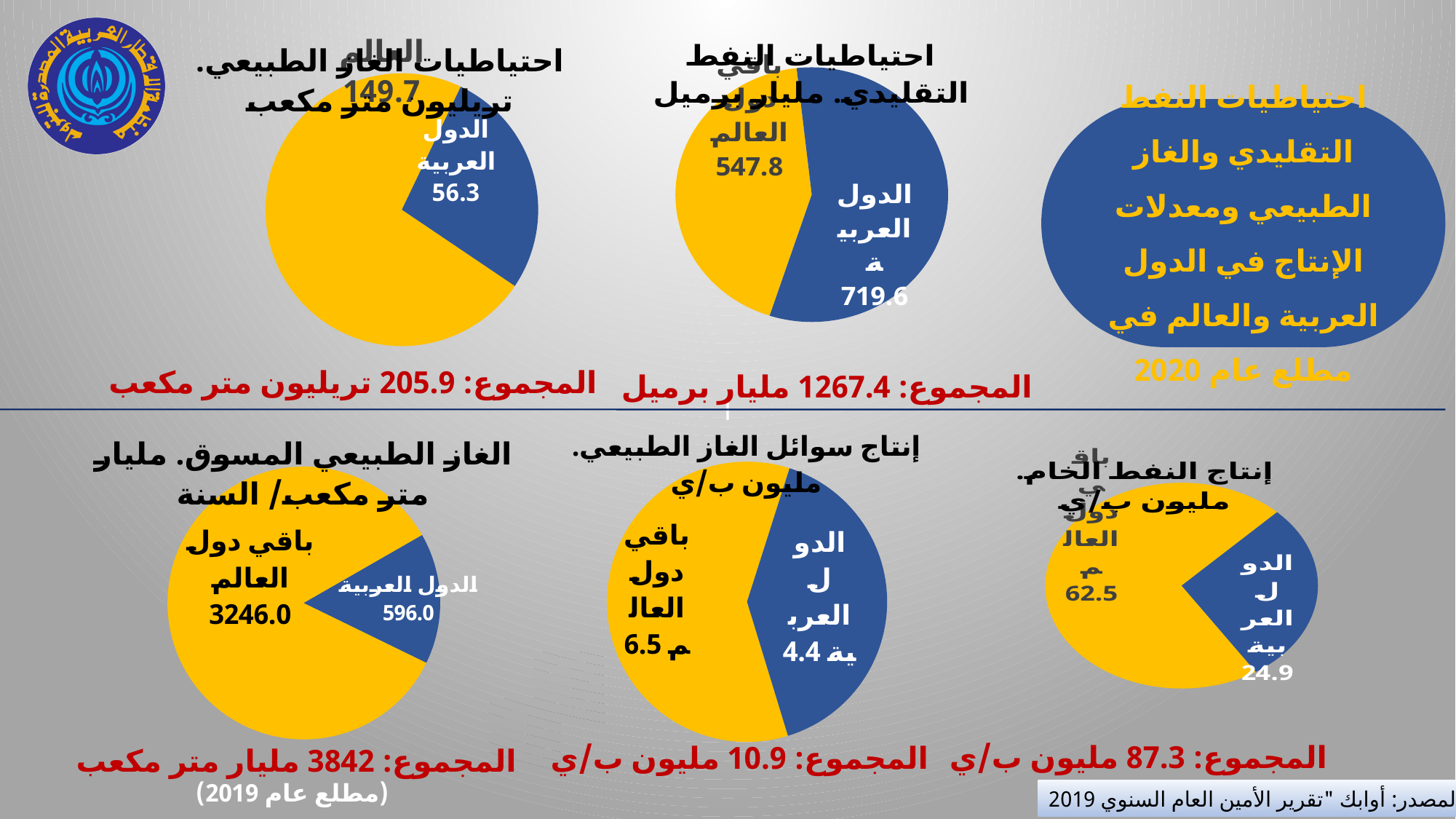
In the top-left pie chart (natural gas reserves), what is the value for the rest of the world (باقي دول العالم)? 149.7 In the top-middle pie chart (conventional oil reserves), which slice is larger: the Arab countries or the rest of the world? الدول العربية (Arab countries) In the bottom-left pie chart (marketed natural gas, billion cubic meters/year), what is the value for the rest of the world? 3246.0 In the bottom-middle pie chart (NGL production), what is the total shown for the two slices? 10.9 In the top-left pie chart (natural gas reserves, trillion cubic meters), what is the value for the Arab countries (الدول العربية)? 56.3 In the top-middle pie chart (conventional oil reserves, billion barrels), what is the value for the Arab countries? 719.6 How many pie charts are shown on the slide? 5 In the bottom-middle pie chart (NGL production, million b/d), what is the value for the Arab countries? 4.4 In the bottom-right pie chart (crude oil production), which slice is smaller? الدول العربية (Arab countries) In the bottom-left pie chart (marketed natural gas), what is the value for the Arab countries? 596.0 In the top-middle pie chart (conventional oil reserves), what is the difference between the Arab countries and the rest of the world? 171.8 In the bottom-right pie chart (crude oil production, million b/d), what is the value for the rest of the world? 62.5